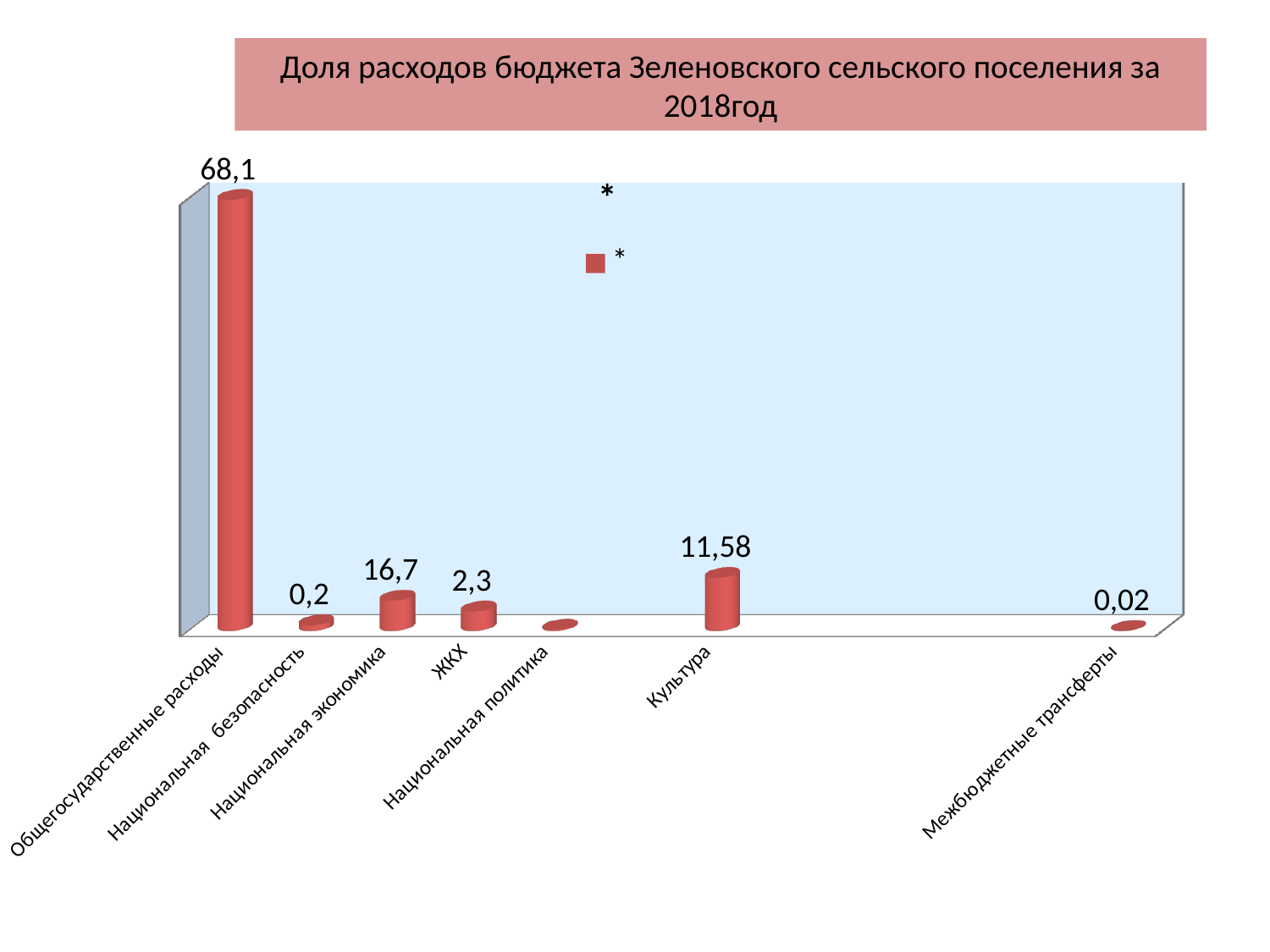
What is the difference between the values for Национальная экономика and Культура? 5,12 What kind of chart is shown on the slide? Bar chart What is the value for Межбюджетные трансферты? 0,02 Which category has the highest value? Общегосударственные расходы What is the value for Культура? 11,58 What is the difference between the values for Общегосударственные расходы and Национальная экономика? 51,4 What is the value for Национальная экономика? 16,7 What is the title of the chart? * How many series does the legend list? 1 What is the value for Общегосударственные расходы? 68,1 What is the value for ЖКХ? 2,3 Which is larger, the value for Культура or the value for ЖКХ? Культура